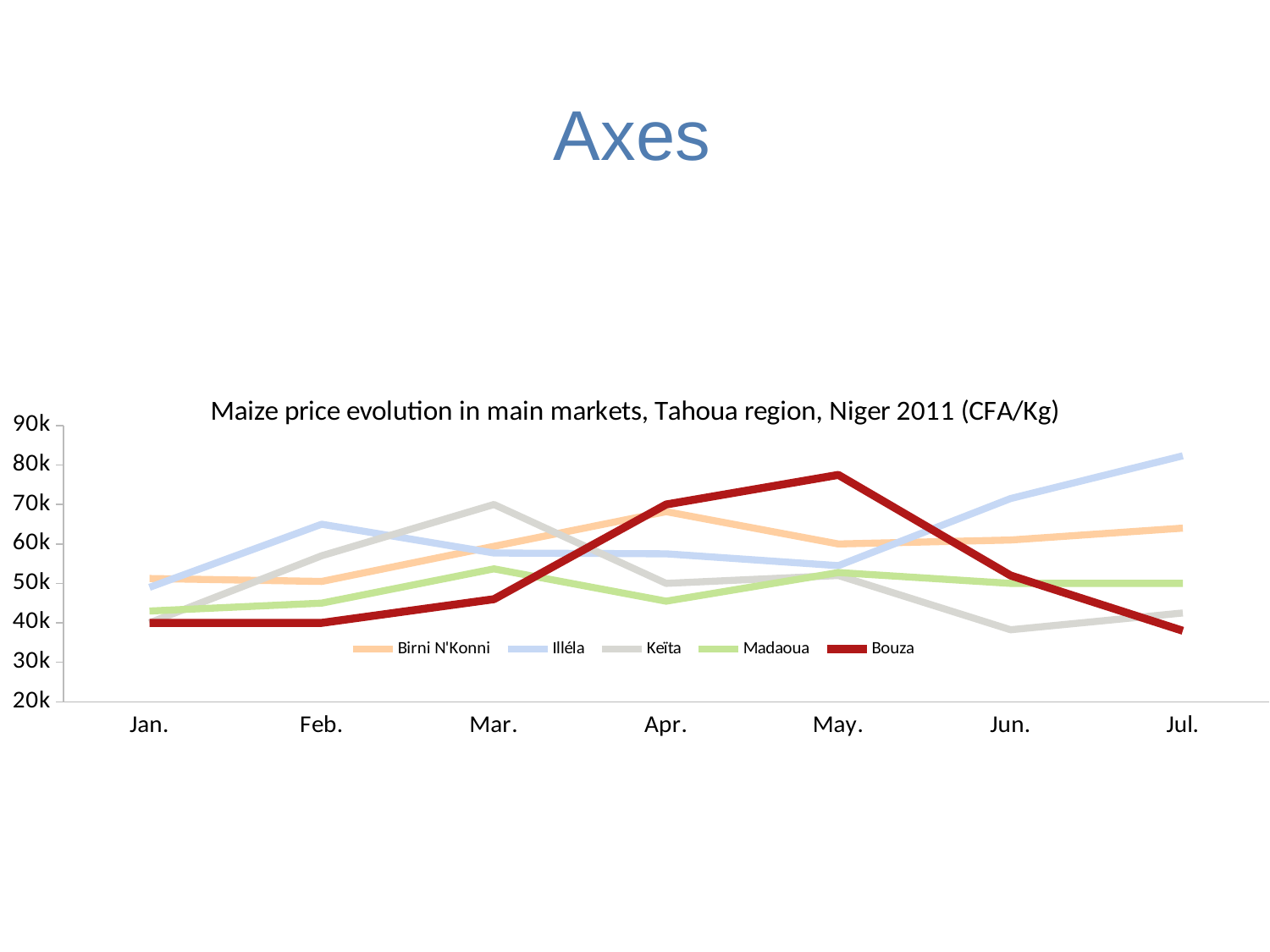
Which series has the highest value in May? Bouza How many months are shown on the x axis? 7 How many series does the legend list? 5 Is the value for Illéla in Jul. greater or less than 80k? greater Is the value for Bouza in Jul. greater or less than 40k? less What is the value for Bouza in Jan.? 40k What kind of chart is shown on the slide? line chart Which is larger in Feb., the value for Illéla or the value for Madaoua? Illéla Which series has the lowest value in Jun.? Keïta What is the value for Keïta in Mar.? 70k Which series has the highest value in Jul.? Illéla What is the title of the chart? Maize price evolution in main markets, Tahoua region, Niger 2011 (CFA/Kg)